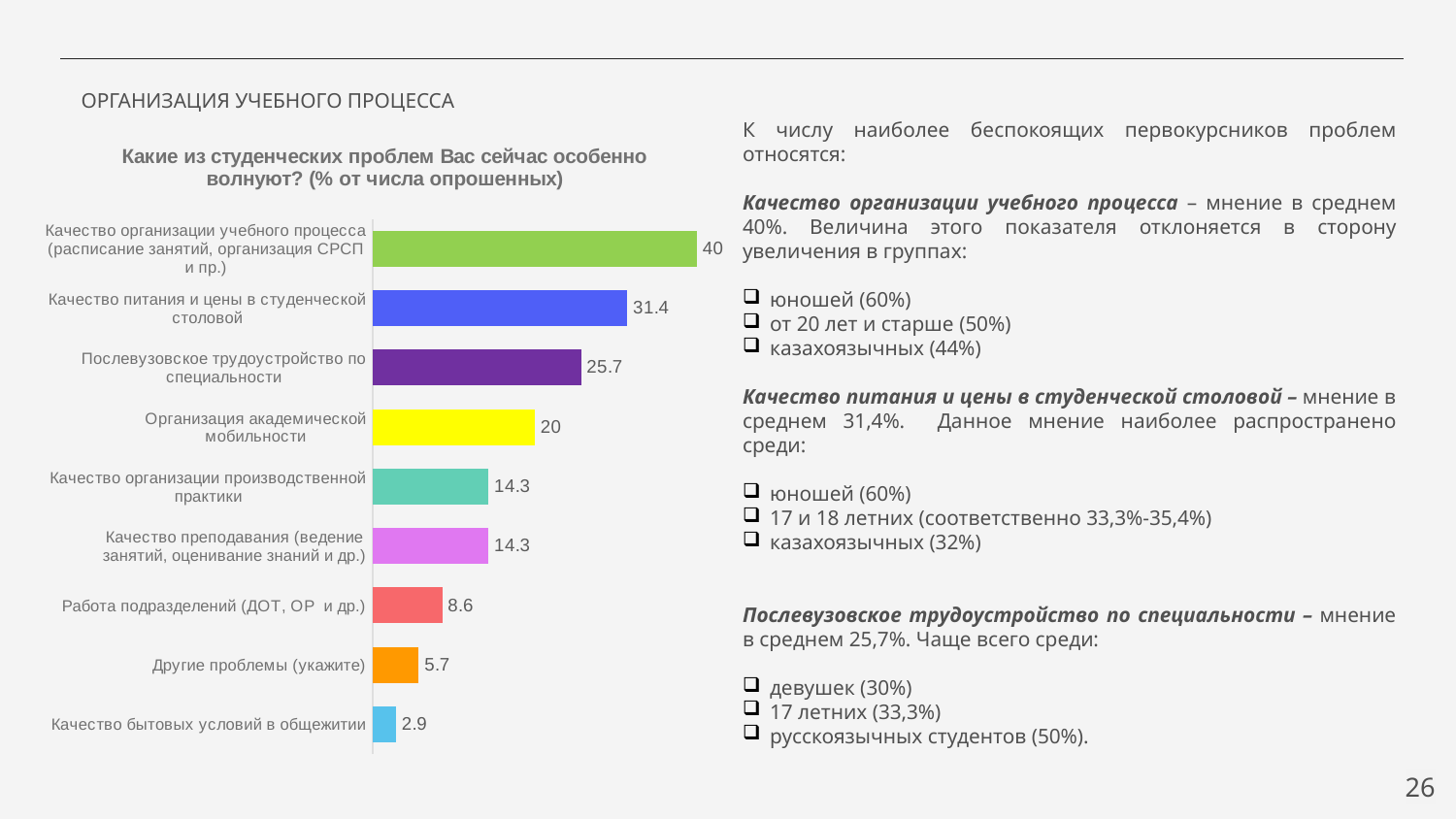
What is the value for "Качество питания и цены в студенческой столовой"? 31.4 What is the title of the chart? Какие из студенческих проблем Вас сейчас особенно волнуют? (% от числа опрошенных) What is the difference between the values for "Качество организации учебного процесса" and "Качество питания и цены в студенческой столовой"? 8.6 What is the value for "Послевузовское трудоустройство по специальности"? 25.7 What colour is the bar for "Качество организации учебного процесса"? Green What kind of chart is shown on the slide? Bar chart Which category has the highest value? Качество организации учебного процесса (расписание занятий, организация СРСП и пр.) How many categories are shown in the chart? 9 What is the value for "Работа подразделений (ДОТ, ОР и др.)"? 8.6 What is the difference between the values for "Организация академической мобильности" and "Другие проблемы (укажите)"? 14.3 Which category has the lowest value? Качество бытовых условий в общежитии Which is larger: the value for "Послевузовское трудоустройство по специальности" or for "Организация академической мобильности"? Послевузовское трудоустройство по специальности